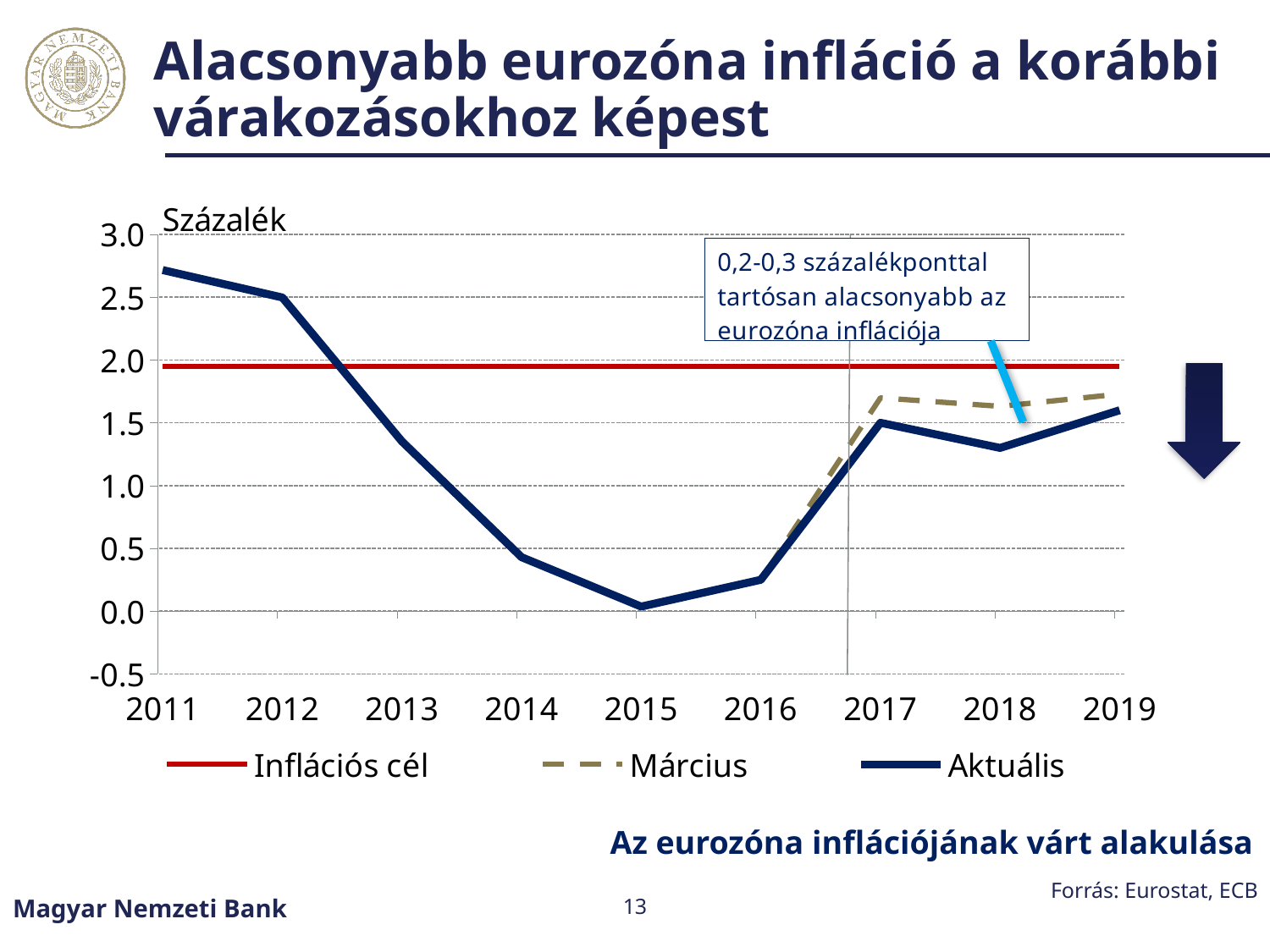
Is the Aktuális value for 2011 greater or less than 2.5? greater In which year is the Aktuális series at its highest? 2011 Is the Inflációs cél line greater or less than 1.5? greater How many series does the legend list? 3 In 2018, which series is higher: Március or Aktuális? Március How many years are labelled on the x axis? 9 In which year does the Aktuális series reach its lowest value? 2015 Is the Aktuális value for 2015 greater or less than 0.5? less What unit label is shown at the top of the y axis? Százalék What kind of chart is shown on the slide? line chart Does the Aktuális series rise or fall between 2011 and 2015? fall